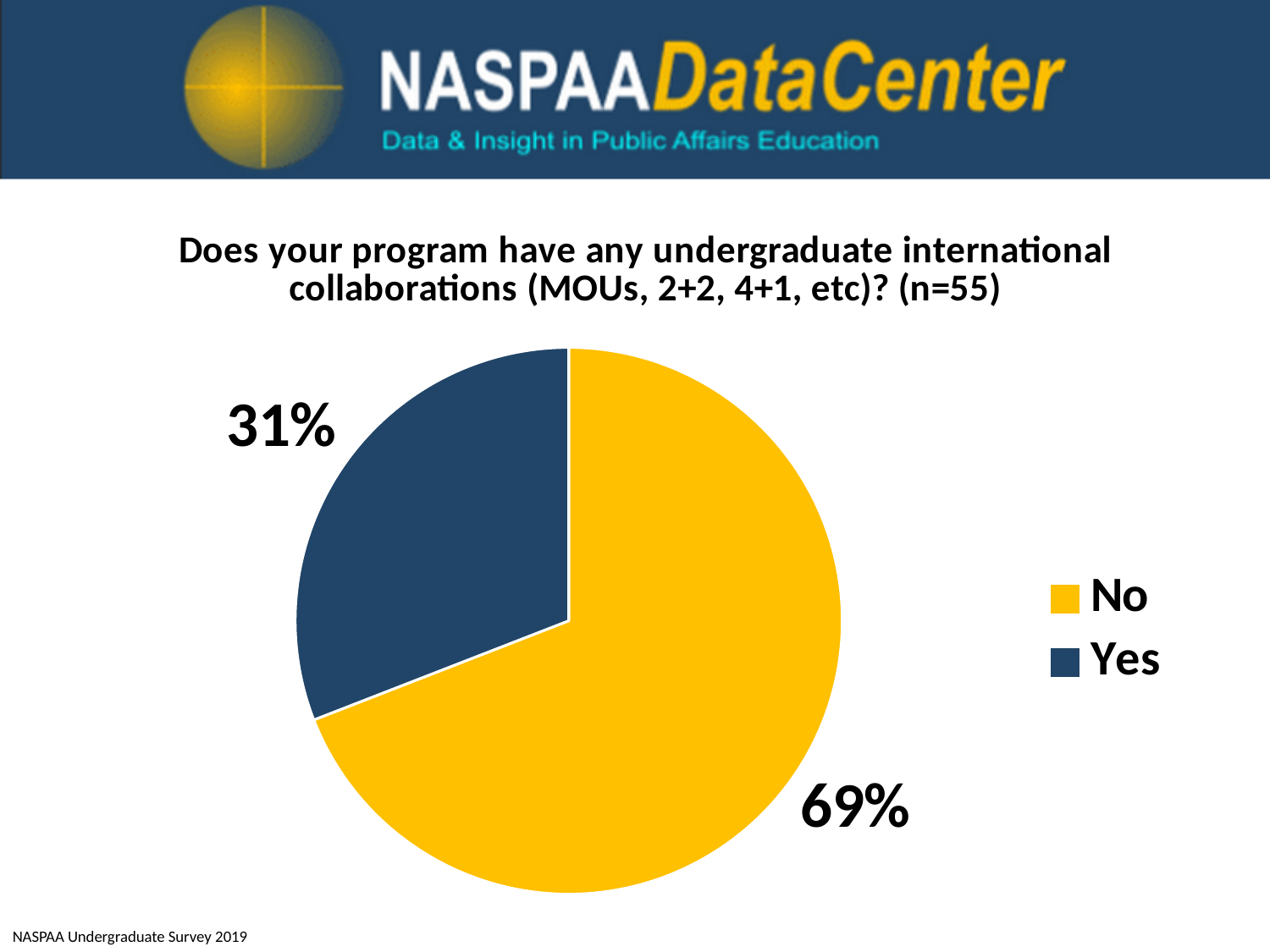
What is the difference in percentage points between the "No" and "Yes" shares? 38 How many entries does the legend list? 2 How many slices does the pie chart have? 2 Which is larger, the share for "Yes" or the share for "No"? No What percentage of programs answered "No"? 69% What percentage of programs answered "Yes"? 31% What colour is the "No" slice in the pie chart? yellow What share of the pie does the "Yes" slice represent? 31% What kind of chart is shown on the slide? pie chart Which response has the smallest share of the pie? Yes How many programs responded to the survey question, according to the chart title? 55 Which response has the largest share of the pie? No